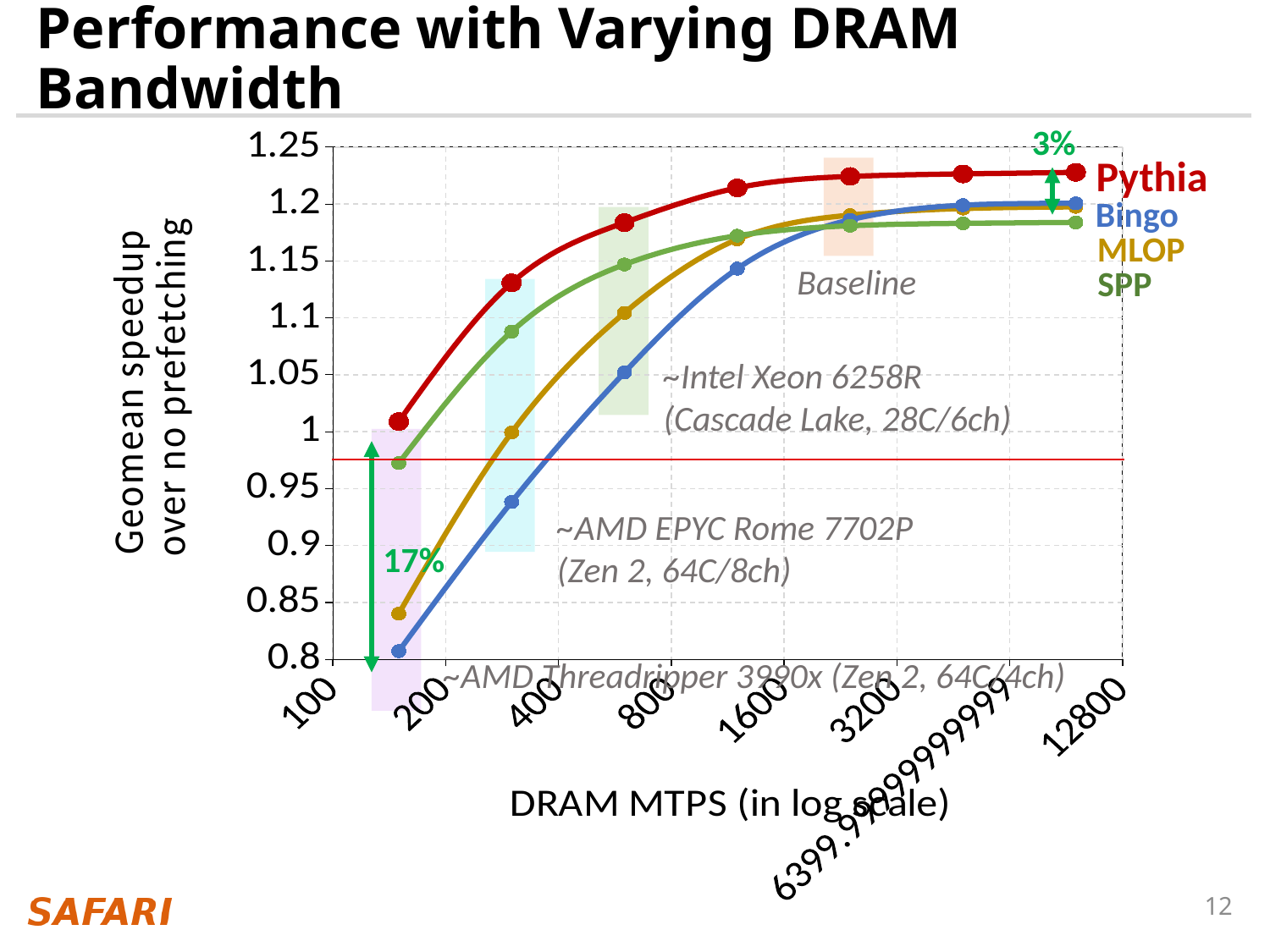
What percentage is annotated for the gap between Pythia and Bingo at the rightmost data point? 3% At the second data point from the left, which series is higher: SPP or MLOP? SPP How many data points does each series have? 7 Is the value for Pythia at the rightmost data point greater or less than 1.2? greater Does the Pythia series rise or fall as DRAM MTPS increases? rises What kind of chart is shown on the slide? line chart Which series has the highest speedup at the leftmost data point? Pythia Which series has the lowest speedup at the leftmost data point? Bingo What is the title of the x axis? DRAM MTPS (in log scale) What percentage is annotated for the gap between Pythia and Bingo at the leftmost data point? 17% How many series does the chart show? 4 Is the value for Bingo at the leftmost data point greater or less than 0.85? less